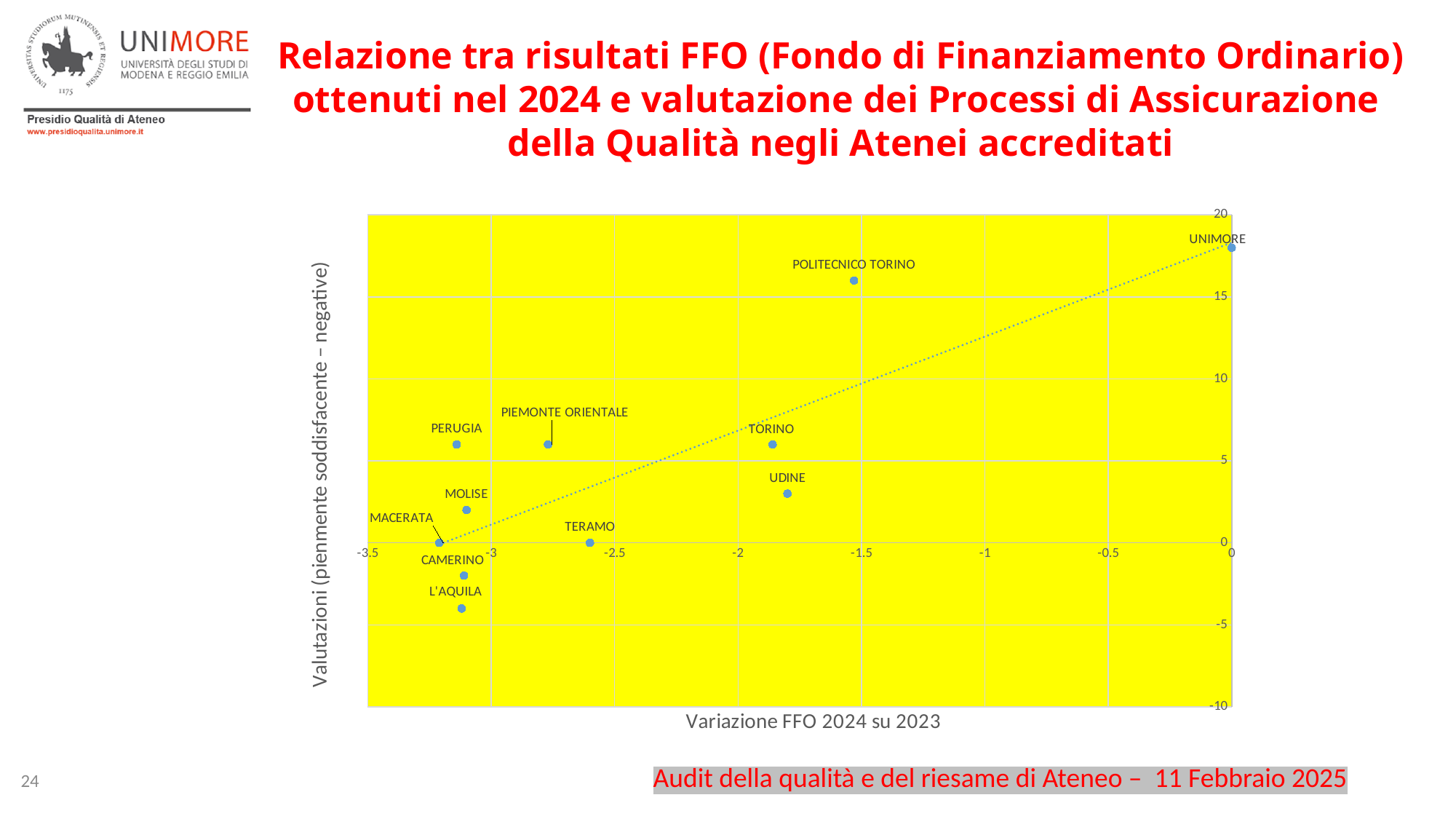
Which university is plotted furthest to the right on the Variazione FFO 2024 su 2023 axis? UNIMORE Is the Valutazioni value for POLITECNICO TORINO greater or less than 15? greater Is the Valutazioni value for L'AQUILA greater or less than 0? less Which university has the lowest value on the vertical axis (Valutazioni)? L'AQUILA According to the dotted trend line, do the Valutazioni values rise or fall as Variazione FFO increases along the x axis? rise Which university has the highest value on the vertical axis (Valutazioni)? UNIMORE Is the Variazione FFO 2024 su 2023 value for POLITECNICO TORINO greater or less than -2? greater How many universities are plotted as points on the chart? 11 What is the title of the horizontal axis of the chart? Variazione FFO 2024 su 2023 Which has the higher Valutazioni value, TORINO or UDINE? TORINO What kind of chart is shown on the slide? scatter chart